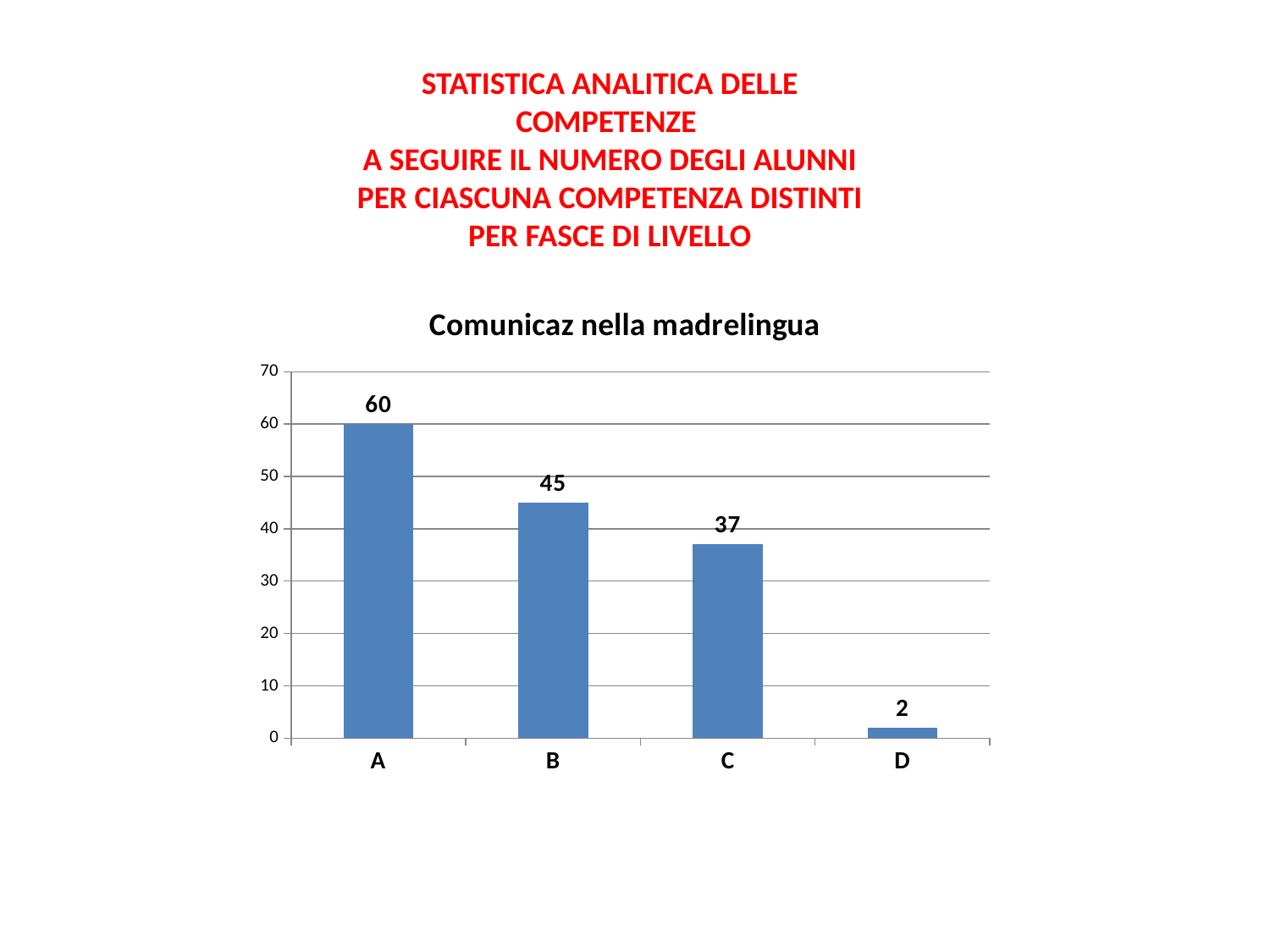
What kind of chart is shown? bar chart What is the value for category A? 60 What is the difference between the values for C and D? 35 What is the value for category C? 37 Is the value for B greater or less than 40? greater Do the values rise or fall from A to D? fall How many categories are shown on the x axis? 4 What is the difference between the values for A and B? 15 What is the value for category D? 2 Which category has the lowest value? D Which is larger, the value for B or the value for C? B Which category has the highest value? A